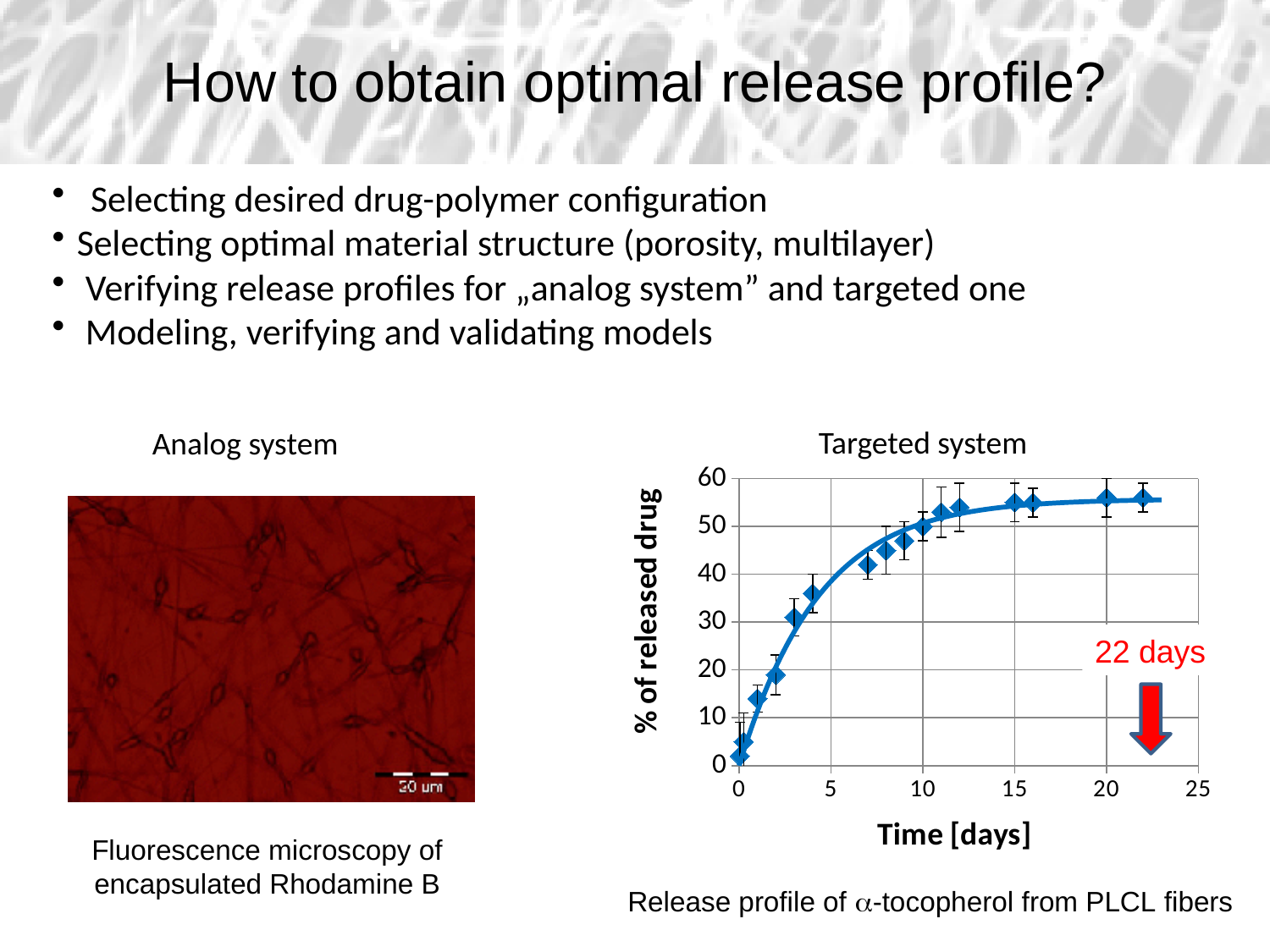
In the "Targeted system" chart, is the value at 4 days greater or less than 30? greater What kind of chart is shown under the heading "Targeted system"? line chart In the "Targeted system" chart, which is larger: the value at 3 days or the value at 15 days? 15 days In the "Targeted system" chart, do the values rise or fall as time increases? rise What is the label of the y axis of the "Targeted system" chart? % of released drug In the "Targeted system" chart, is the value at 22 days greater or less than 50? greater In the "Targeted system" chart, is the value at 1 day greater or less than 20? less In the "Targeted system" chart, at which time is the released drug percentage lowest? 0 days What is the title of the chart on the right side of the slide? Targeted system